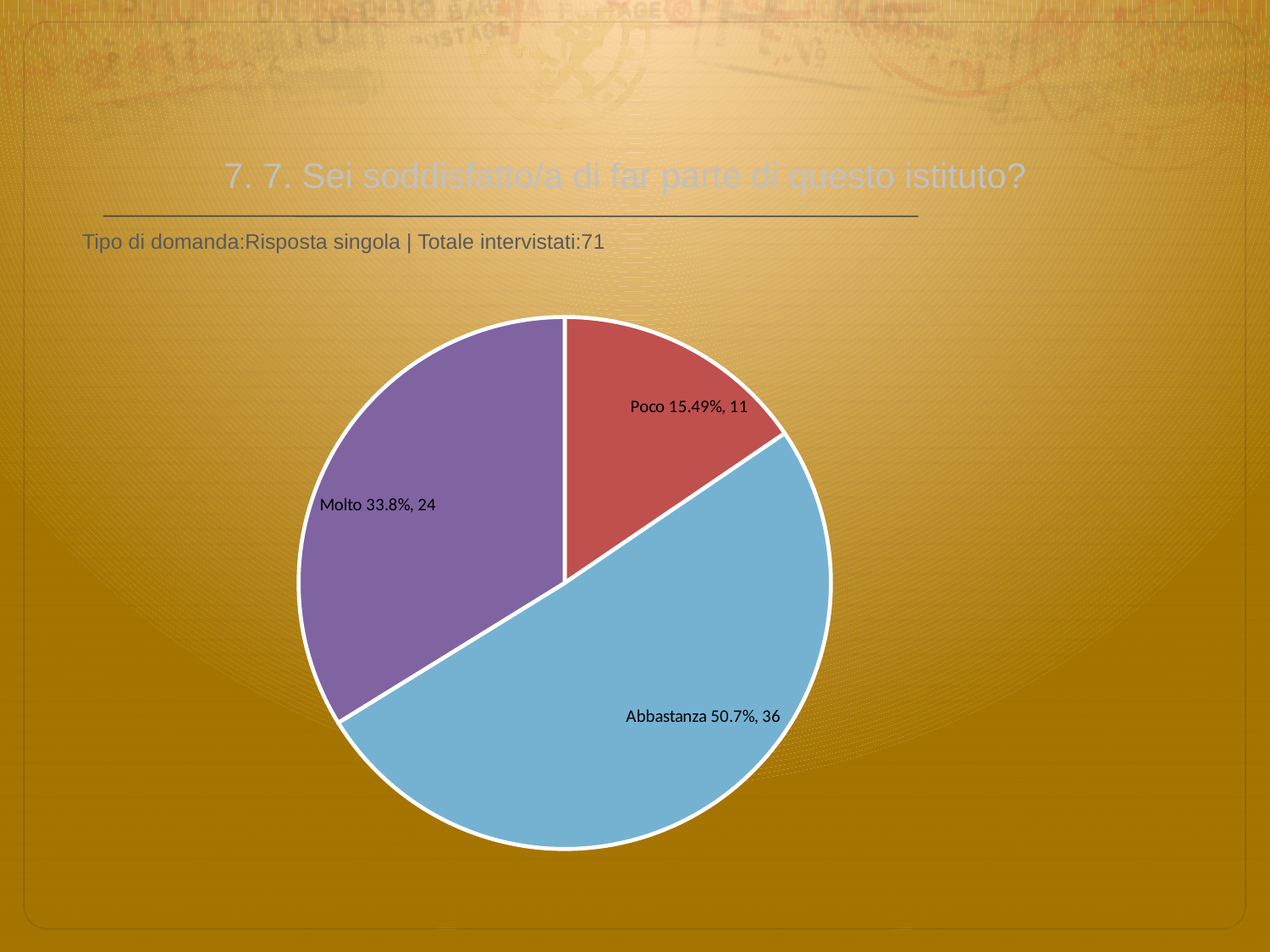
Which category has the smallest slice? Poco How many slices does the pie chart have? 3 How many respondents answered Abbastanza? 36 What percentage share does the Abbastanza slice have? 50.7% Which has more respondents, Molto or Poco? Molto What percentage share does the Molto slice have? 33.8% How many respondents answered Molto? 24 What percentage share does the Poco slice have? 15.49% What is the difference in respondent count between Abbastanza and Molto? 12 What kind of chart is shown on the slide? pie chart How many respondents answered Poco? 11 Which category has the largest slice? Abbastanza